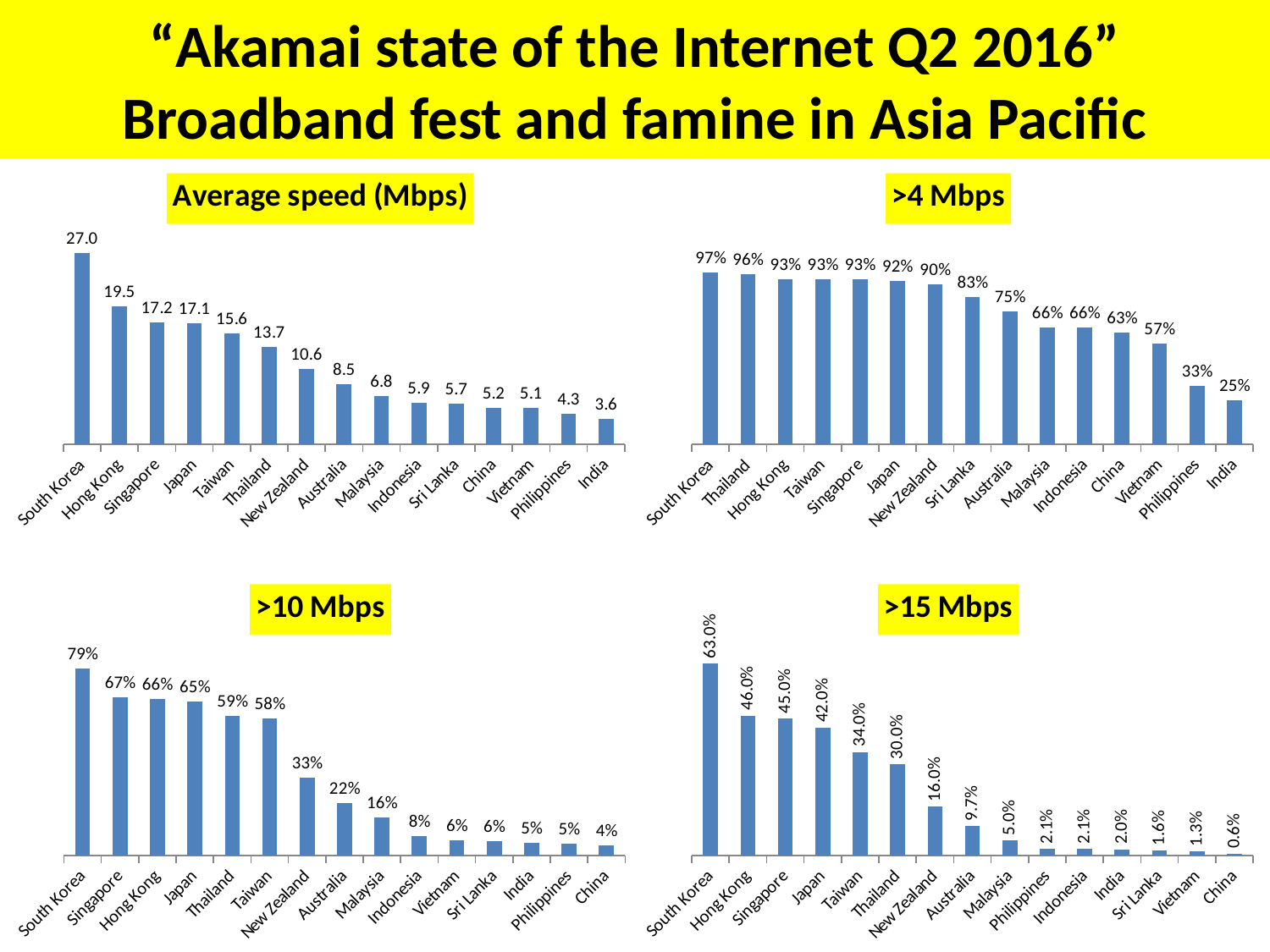
How many countries are shown in the ">15 Mbps" chart? 15 In the ">10 Mbps" chart, what is the value for New Zealand? 33% In the ">4 Mbps" chart, which is larger, the value for Australia or the value for Vietnam? Australia In the "Average speed (Mbps)" chart, what is the value for Hong Kong? 19.5 What type of chart is the ">15 Mbps" chart? Bar chart In the ">10 Mbps" chart, which country has the lowest value? China In the "Average speed (Mbps)" chart, what is the difference between South Korea and Japan? 9.9 In the "Average speed (Mbps)" chart, which country has the lowest average speed? India In the ">10 Mbps" chart, what is the difference between Singapore and Australia? 45% In the ">15 Mbps" chart, what is the value for Thailand? 30.0% In the ">4 Mbps" chart, what is the value for Sri Lanka? 83% In the ">4 Mbps" chart, which country has the highest value? South Korea